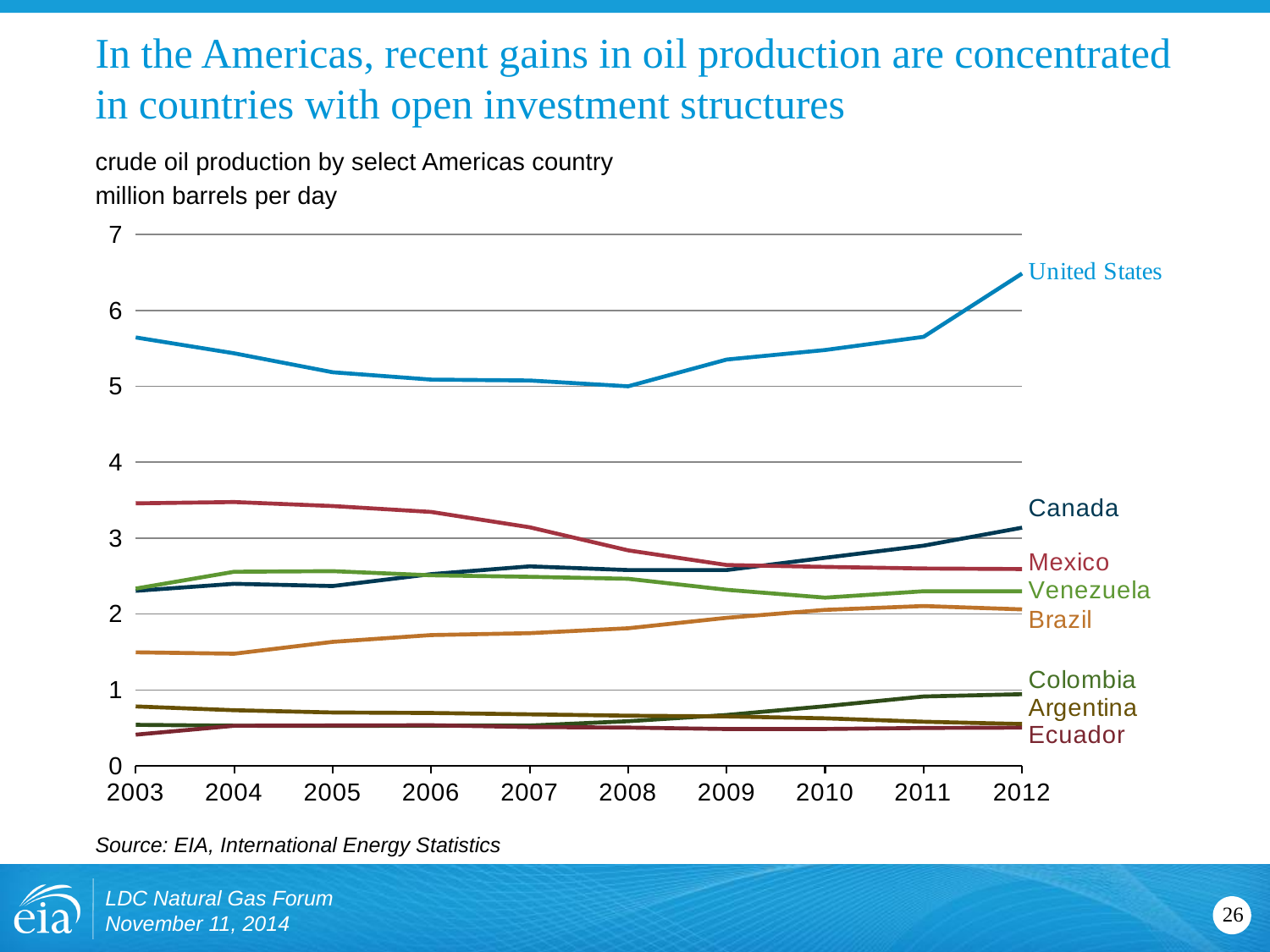
What kind of chart is shown on the slide? line chart How many countries are plotted on the chart? 8 Is the value for Mexico in 2003 greater or less than 3? greater What unit of measurement is used on the chart? million barrels per day Is the value for Brazil in 2003 greater or less than 2? less In 2012, which is larger, the value for Canada or the value for Mexico? Canada Does Brazil's crude oil production rise or fall from 2003 to 2012? rise Which country has the highest crude oil production in 2012? United States Does Mexico's crude oil production rise or fall from 2003 to 2012? fall How many years are shown along the x axis of the chart? 10 Which country has the lowest crude oil production in 2012? Ecuador Is the value for the United States in 2012 greater or less than 6? greater